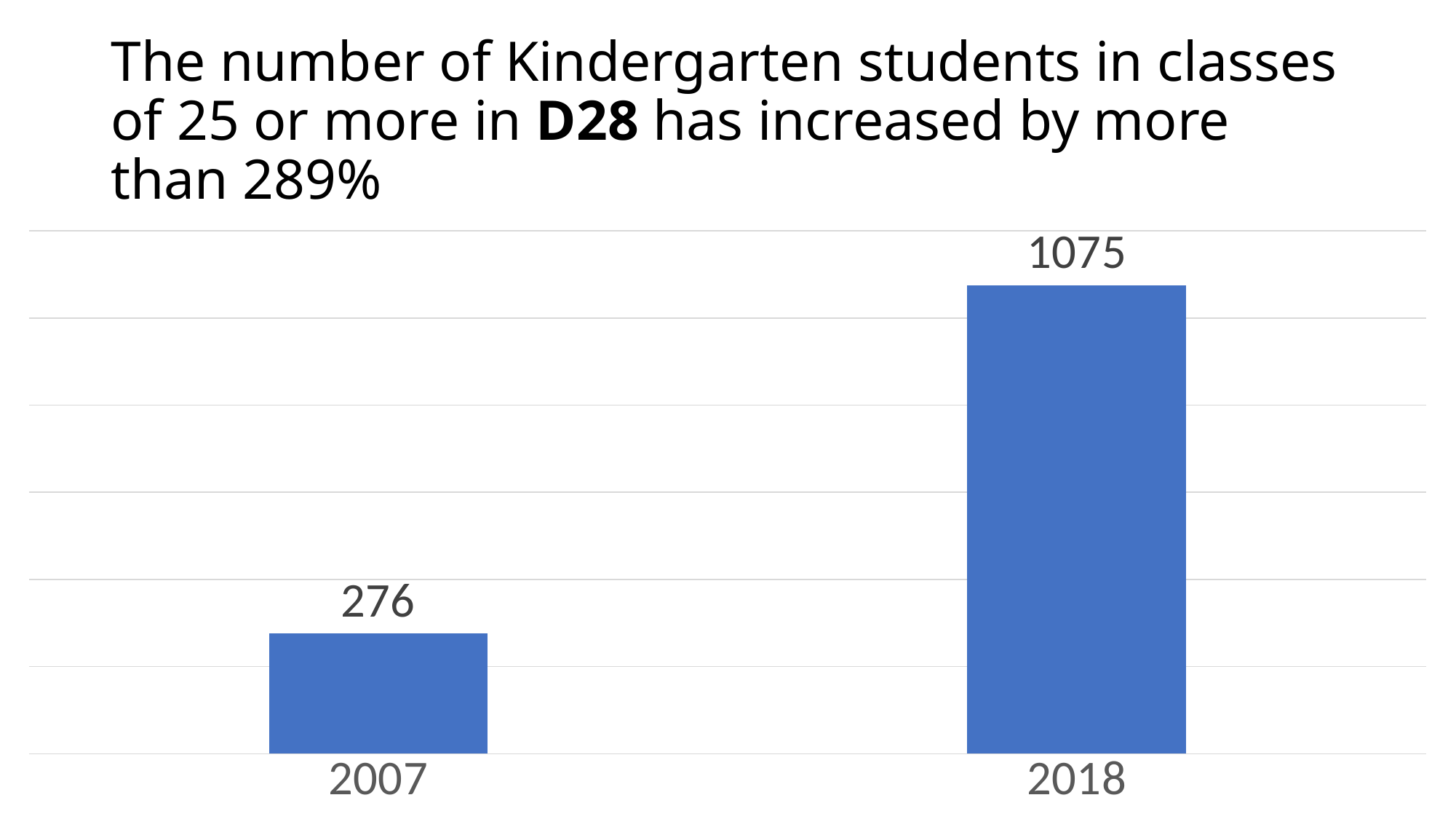
How many categories are shown on the x axis? 2 Which district is named in the chart title? D28 What is the difference between the values for 2018 and 2007? 799 Which is larger, the value for 2007 or the value for 2018? 2018 Do the values rise or fall from 2007 to 2018? rise What is the value for 2007? 276 What is the total of the two values shown? 1351 What kind of chart is shown on the slide? bar chart Which year has the highest value? 2018 Which year has the lowest value? 2007 What is the value for 2018? 1075 What colour are the bars in the chart? blue